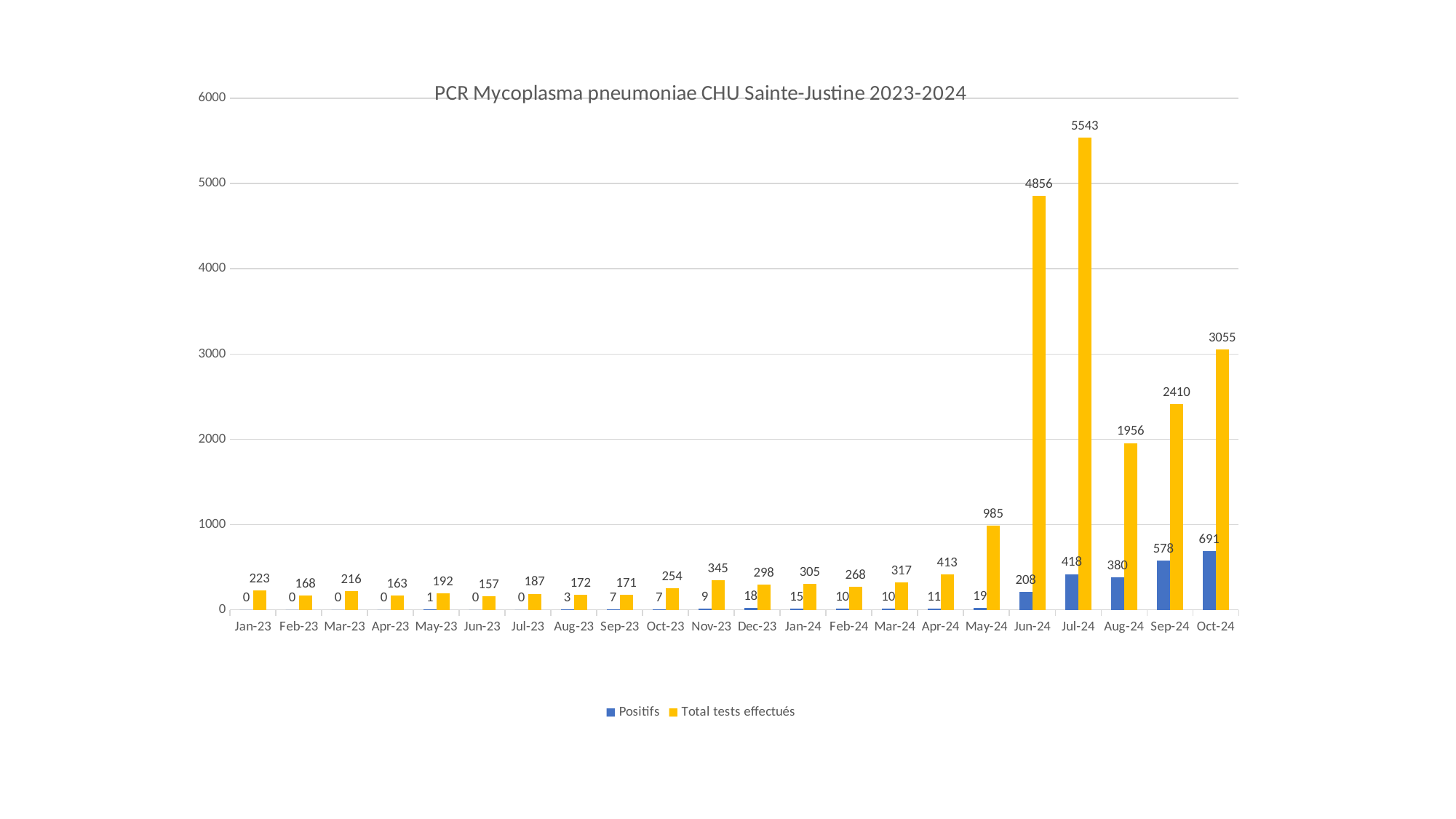
Which month has the highest value for Positifs? Oct-24 How many series does the legend list? 2 Which month has the lowest value for Total tests effectués? Jun-23 Which is larger, Positifs in Jul-24 or Positifs in Aug-24? Jul-24 What is the value of Positifs for Oct-24? 691 What kind of chart is shown on the slide? Bar chart What is the value of Total tests effectués for Nov-23? 345 Which month has the highest value for Total tests effectués? Jul-24 What is the difference between Total tests effectués in Jul-24 and Jun-24? 687 What is the value of Total tests effectués for Jul-24? 5543 What is the value of Positifs for Dec-23? 18 How many months are shown on the x axis? 22